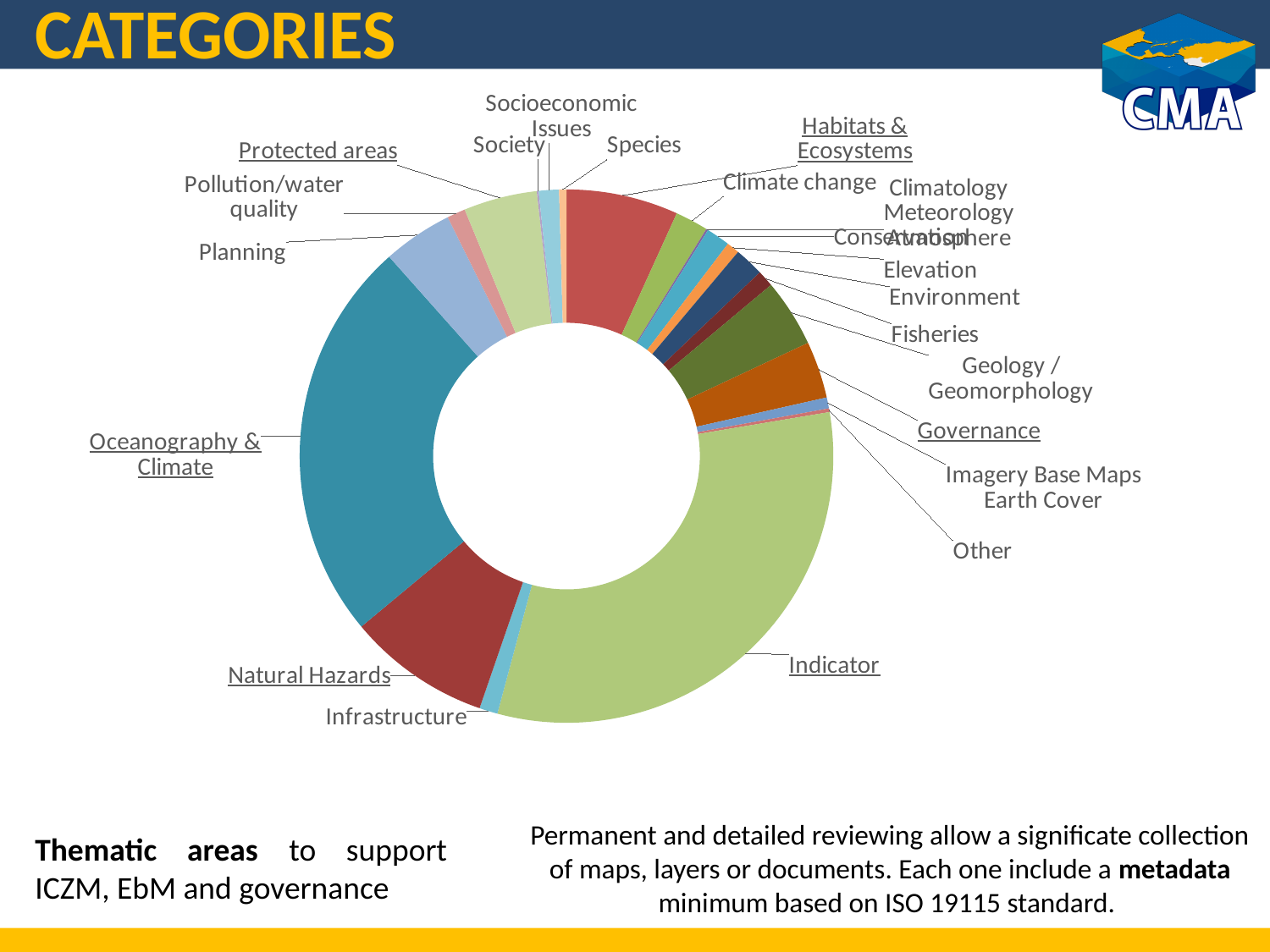
Which slice is larger, Natural Hazards or Infrastructure? Natural Hazards Which slice is larger, Oceanography & Climate or Natural Hazards? Oceanography & Climate Which category has the largest slice in the chart? Indicator What is the title of the slide containing the chart? CATEGORIES What colour is the Oceanography & Climate slice? teal Which slice is larger, Habitats & Ecosystems or Species? Habitats & Ecosystems What kind of chart is shown on the slide? doughnut chart